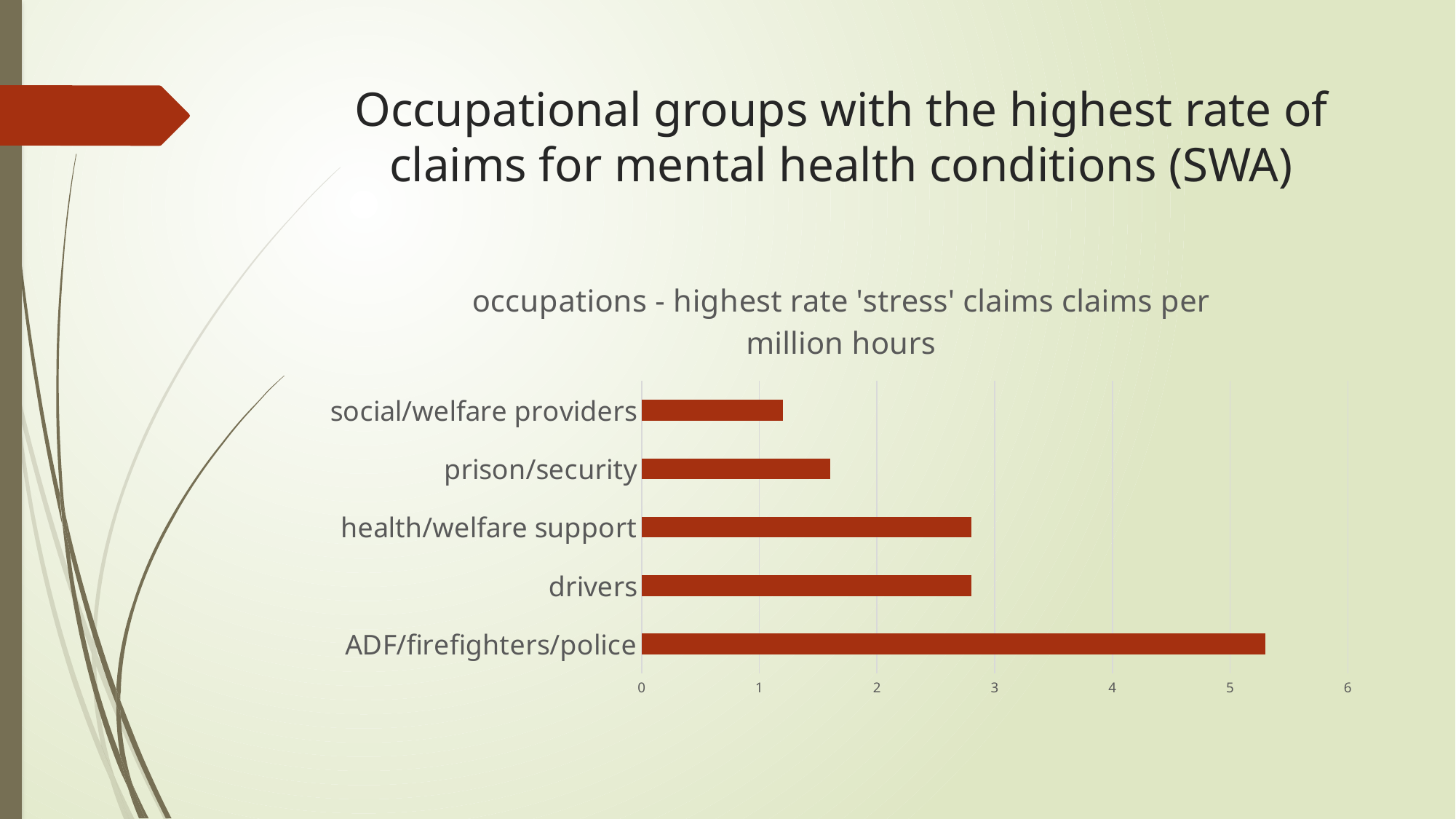
Which occupational group has the highest rate of 'stress' claims per million hours? ADF/firefighters/police What is the highest value shown on the horizontal axis of the chart? 6 Is the value for ADF/firefighters/police greater or less than 5? greater Which occupational group has the lowest rate of 'stress' claims per million hours? social/welfare providers What kind of chart is shown on the slide? bar chart Is the value for health/welfare support greater or less than 2? greater Is the value for drivers greater or less than 3? less How many occupational groups are plotted in the chart? 5 What is the title of the chart? occupations - highest rate 'stress' claims claims per million hours Which has a higher rate of claims, prison/security or social/welfare providers? prison/security